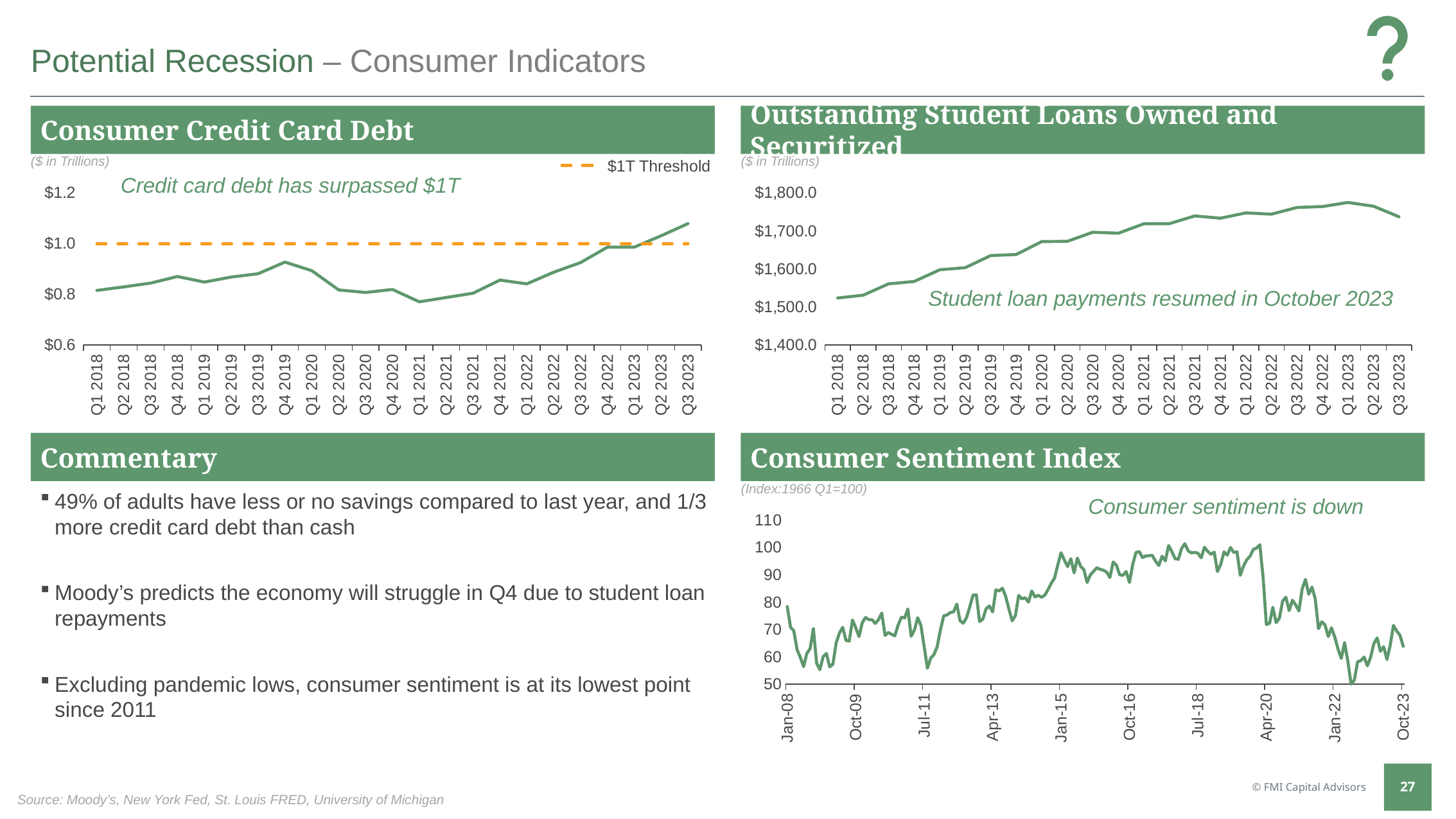
In the Consumer Credit Card Debt chart, is the value for Q1 2021 greater or less than $0.8? less In the Consumer Sentiment Index chart, which is larger, the value at Jan-15 or the value at Jan-22? Jan-15 In the Consumer Credit Card Debt chart, which quarter has the lowest value? Q1 2021 In the Consumer Credit Card Debt chart, which quarter has the highest value? Q3 2023 In the Outstanding Student Loans Owned and Securitized chart, which quarter has the lowest value? Q1 2018 In the Consumer Credit Card Debt chart, how many quarters are plotted on the x axis? 23 In the Outstanding Student Loans Owned and Securitized chart, is the value for Q3 2023 greater or less than $1,700.0? greater What kind of chart is the Consumer Credit Card Debt chart? line chart In the Outstanding Student Loans Owned and Securitized chart, do values generally rise or fall from Q1 2018 to Q1 2023? rise In the Consumer Sentiment Index chart, is the value for Oct-23 greater or less than 70? less In the Consumer Credit Card Debt chart, what does the orange dashed line represent according to the legend? $1T Threshold